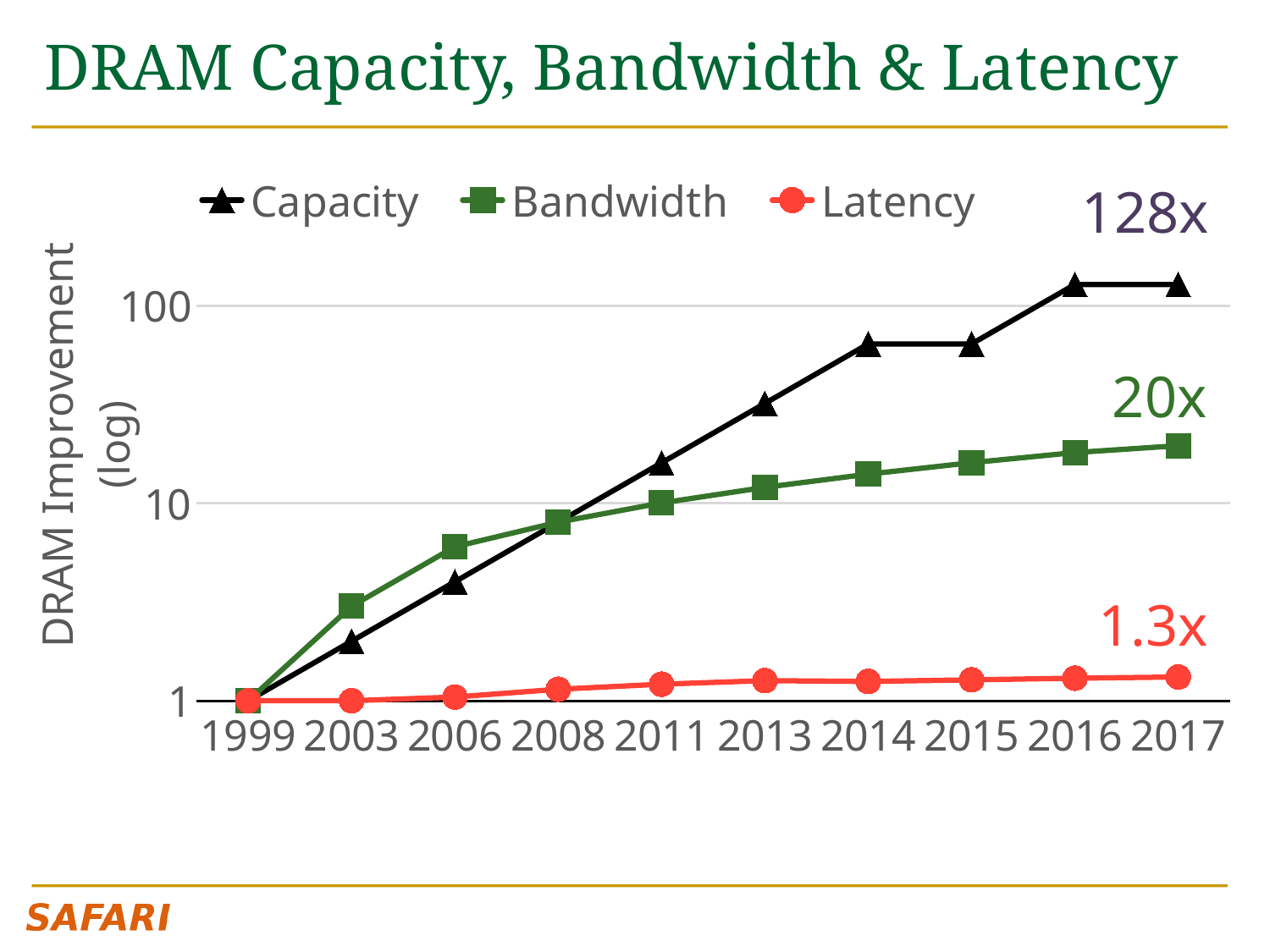
What is the Capacity improvement in 2017? 128x How many series does the legend list? 3 Is the Capacity value for 2013 greater or less than 10? greater Which series has the lowest value in 2017? Latency What is the label on the y axis? DRAM Improvement (log) What kind of chart is shown on the slide? line chart Which series has the highest value in 2017? Capacity What is the Bandwidth improvement in 2017? 20x What is the Latency improvement in 2017? 1.3x Does the Capacity series rise or fall from 1999 to 2017? rise How many years are shown along the x axis? 10 In 2006, which is larger: Bandwidth or Capacity? Bandwidth